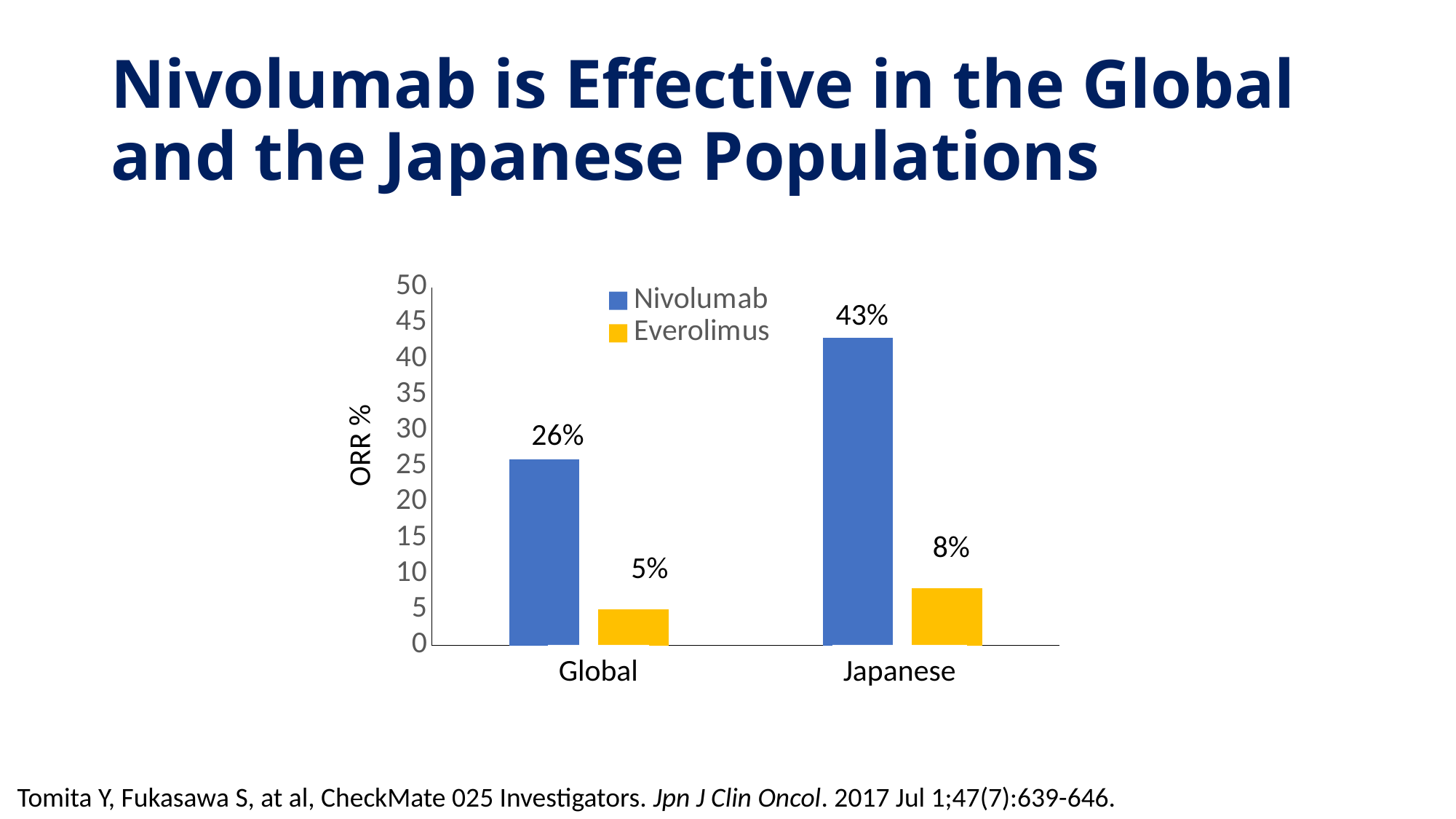
What kind of chart is shown on the slide? Bar chart What is the ORR for Nivolumab in the Japanese population? 43% Which has a higher ORR in the Global population, Nivolumab or Everolimus? Nivolumab Which bar shows the lowest ORR on the chart? Everolimus, Global What is the ORR for Everolimus in the Japanese population? 8% Which bar shows the highest ORR on the chart? Nivolumab, Japanese What is the ORR for Everolimus in the Global population? 5% What is the difference in Nivolumab ORR between the Japanese and Global populations? 17% What is the label on the vertical axis of the chart? ORR % What is the ORR for Nivolumab in the Global population? 26% How many series does the legend list? 2 What is the difference in ORR between Nivolumab and Everolimus in the Japanese population? 35%